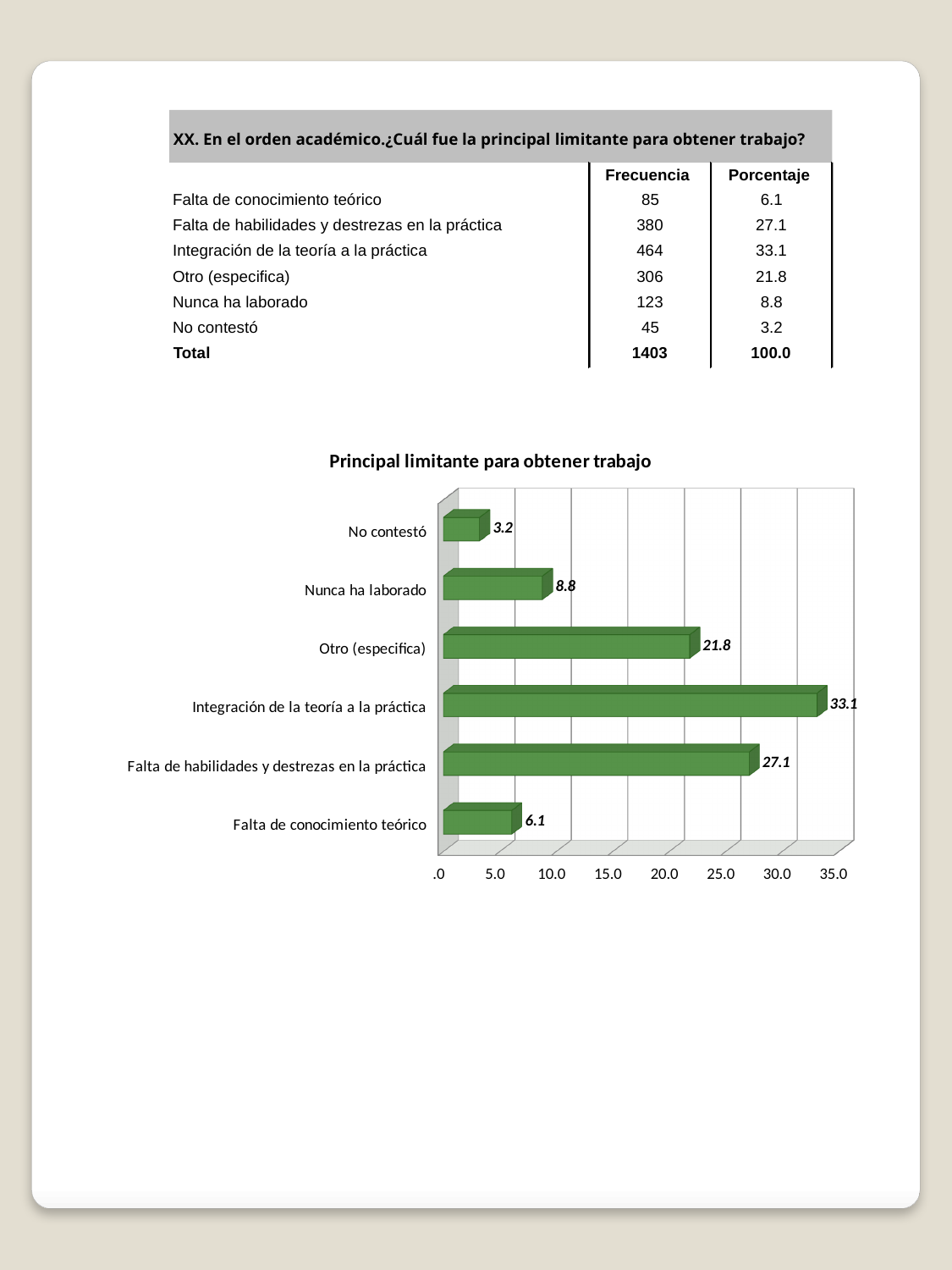
What is the value for 'No contestó' in the chart? 3.2 Which is larger: the value for 'Nunca ha laborado' or the value for 'Falta de conocimiento teórico'? Nunca ha laborado Which category has the lowest value in the chart? No contestó Which category has the highest value in the chart? Integración de la teoría a la práctica What is the highest value shown on the x axis of the chart? 35.0 What is the value for 'Integración de la teoría a la práctica' in the chart? 33.1 How many categories are shown in the chart? 6 What kind of chart is shown on the slide? Bar chart What is the difference between the values for 'Integración de la teoría a la práctica' and 'Falta de habilidades y destrezas en la práctica'? 6.0 What is the title of the chart? Principal limitante para obtener trabajo What is the value for 'Otro (especifica)' in the chart? 21.8 Is the value for 'Otro (especifica)' greater or less than 20.0? greater